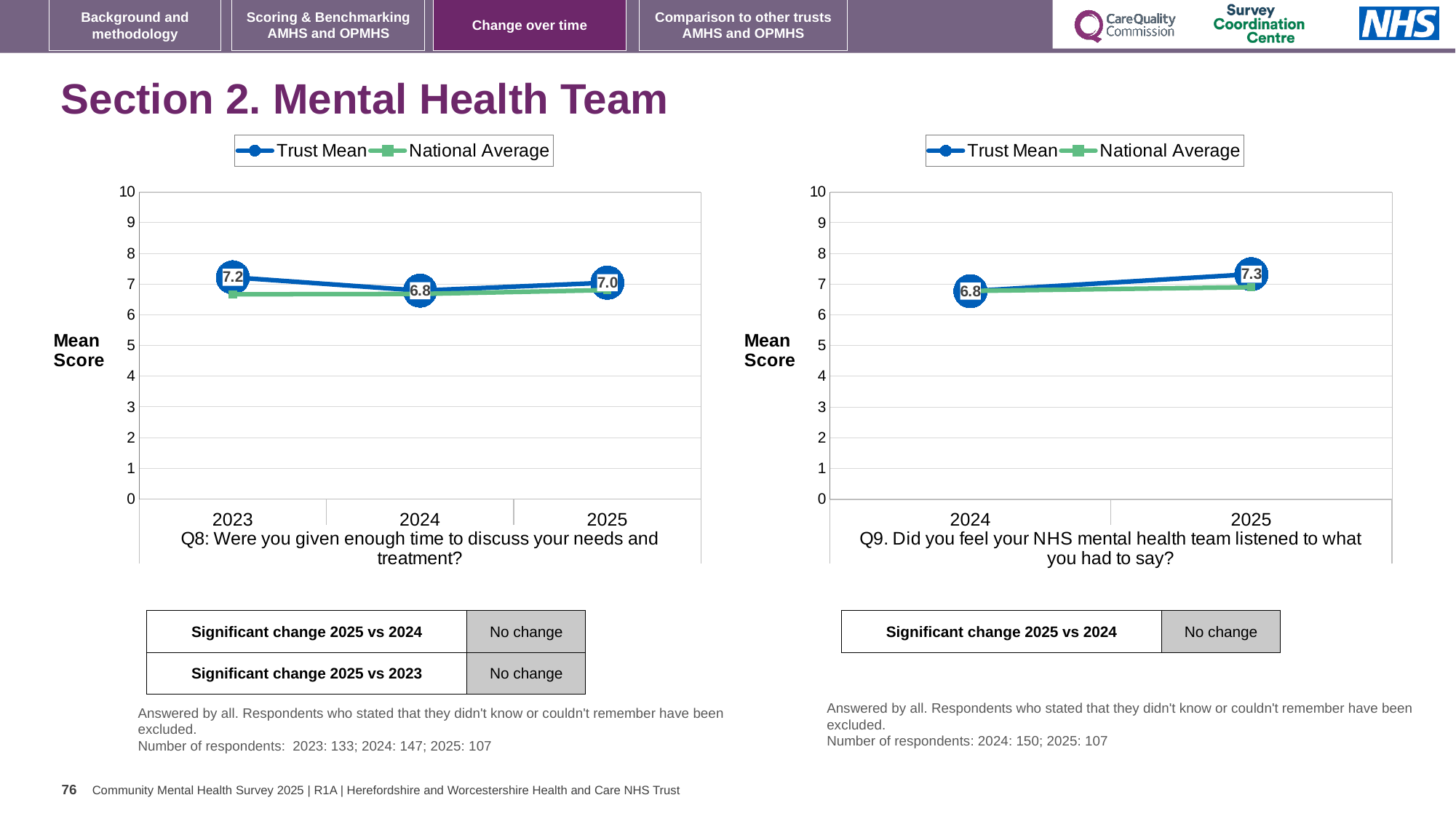
On the left chart (Q8), which year has the highest Trust Mean? 2023 How many years are shown on the x axis of the right chart (Q9)? 2 How many series does the legend of the left chart (Q8) list? 2 On the left chart (Q8), which year has the lowest Trust Mean? 2024 On the left chart (Q8), is the Trust Mean higher in 2023 or in 2025? 2023 On the right chart (Q9), what is the Trust Mean for 2025? 7.3 On the right chart (Q9), does the Trust Mean rise or fall from 2024 to 2025? Rise On the left chart (Q8), is the National Average for 2023 greater or less than 7? less On the left chart (Q8), what is the Trust Mean for 2024? 6.8 On the right chart (Q9), what is the difference between the Trust Mean for 2025 and 2024? 0.5 What kind of chart is the right chart (Q9)? Line chart On the left chart (Q8), what is the Trust Mean for 2023? 7.2